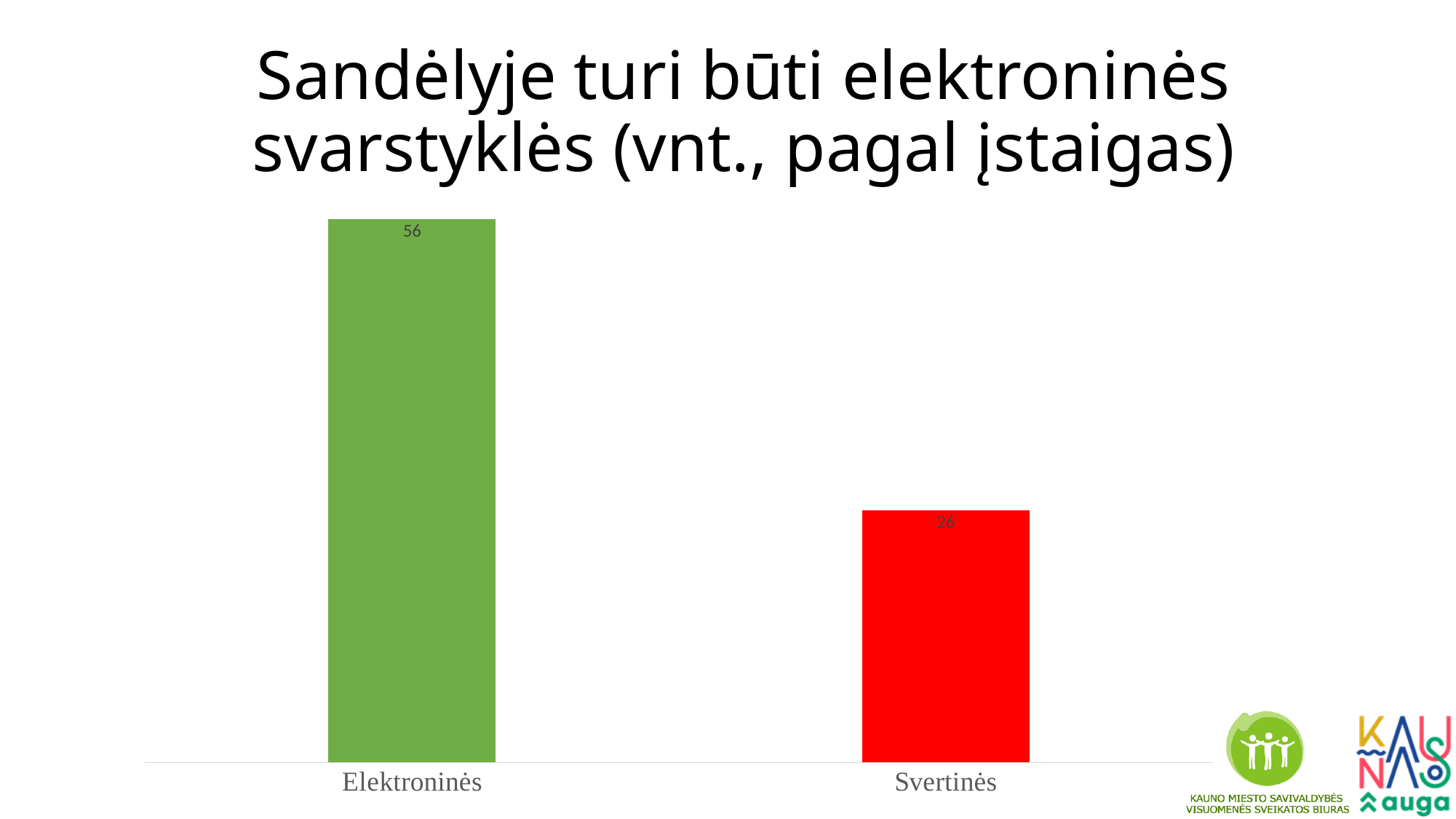
What is the value for Svertinės? 26 What colour is the bar for Svertinės? Red What kind of chart is shown on the slide? Bar chart Which category has the highest value? Elektroninės What is the total of the two bars in the chart? 82 What is the difference between the values for Elektroninės and Svertinės? 30 What is the value for Elektroninės? 56 What colour is the bar for Elektroninės? Green Which is larger, the value for Elektroninės or the value for Svertinės? Elektroninės How many categories are shown in the chart? 2 Which category has the lowest value? Svertinės